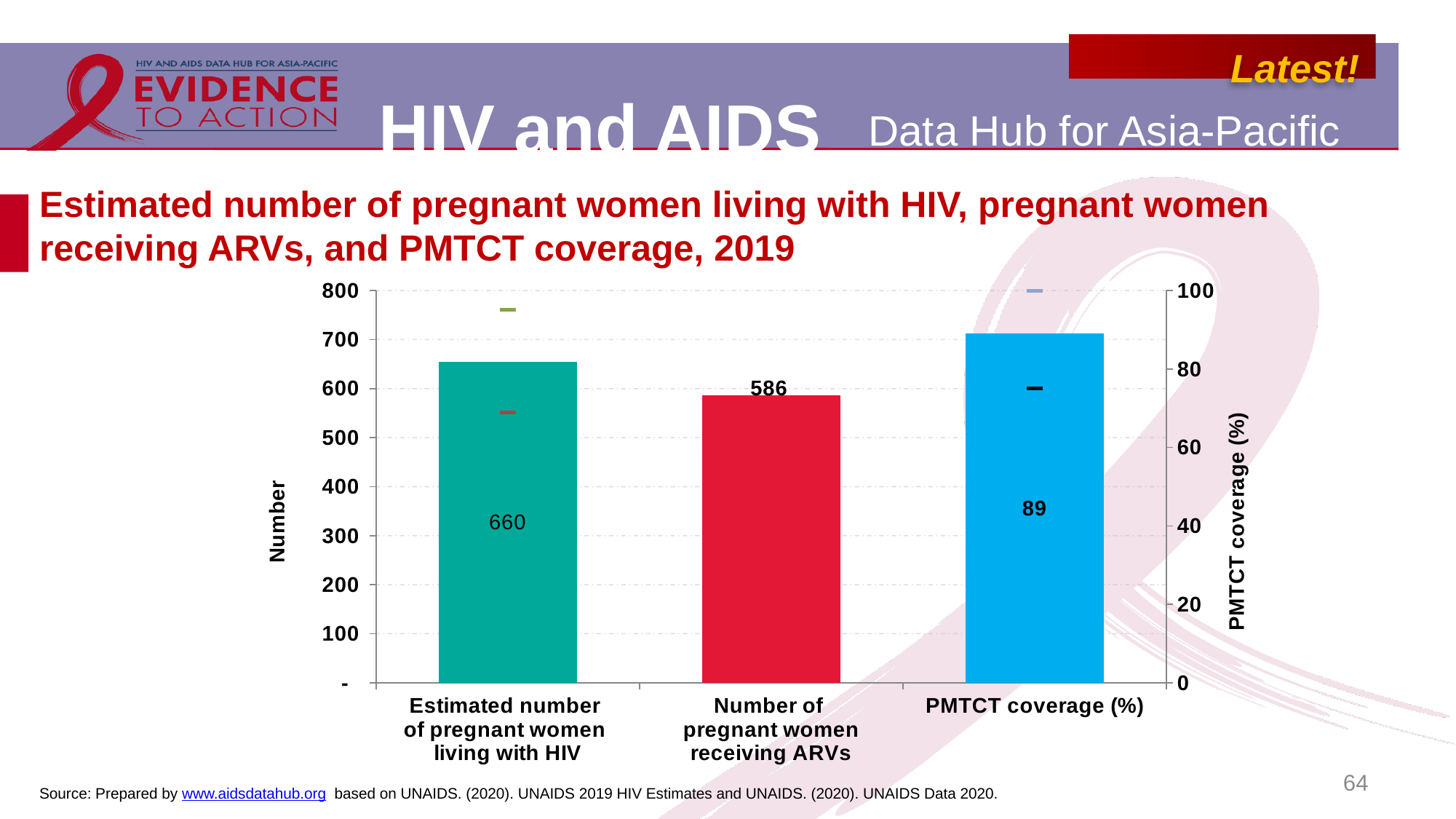
What is the label of the left-hand vertical axis? Number What kind of chart is shown on the slide? Bar chart Which is larger: the estimated number of pregnant women living with HIV or the number of pregnant women receiving ARVs? Estimated number of pregnant women living with HIV How many categories are shown on the x axis of the chart? 3 What is the label of the right-hand vertical axis? PMTCT coverage (%) What is the highest tick value shown on the left-hand vertical axis? 800 What is the estimated number of pregnant women living with HIV shown on the chart? 660 Is the number of pregnant women receiving ARVs greater or less than 600? less What is the PMTCT coverage (%) value shown on the chart? 89 What is the number of pregnant women receiving ARVs shown on the chart? 586 Is the PMTCT coverage (%) value greater or less than 80 on the right-hand axis? greater What is the difference between the estimated number of pregnant women living with HIV and the number of pregnant women receiving ARVs? 74